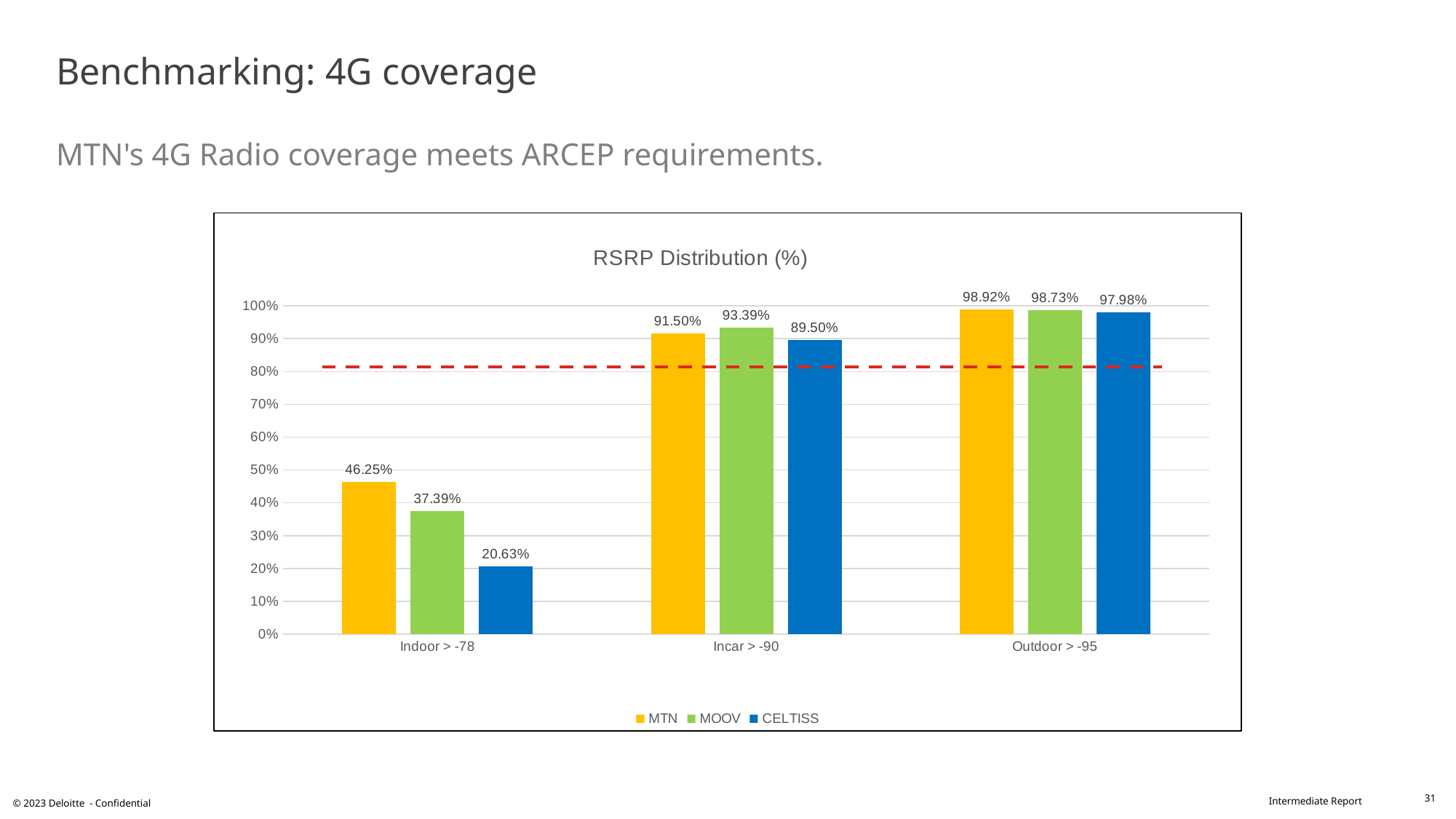
Which operator has the lowest value in the Indoor > -78 category? CELTISS How many categories are shown on the x axis? 3 Which operator has the highest value in the Incar > -90 category? MOOV What is the title of the chart? RSRP Distribution (%) What is the value for MOOV in the Outdoor > -95 category? 98.73% What is the difference between MTN and CELTISS in the Indoor > -78 category? 25.62% What is the value for CELTISS in the Incar > -90 category? 89.50% What is the value for MTN in the Indoor > -78 category? 46.25% What kind of chart is shown on the slide? Bar chart Do the MTN values rise or fall from Indoor > -78 to Outdoor > -95? Rise Which is larger in the Incar > -90 category: MTN or CELTISS? MTN How many series does the legend list? 3